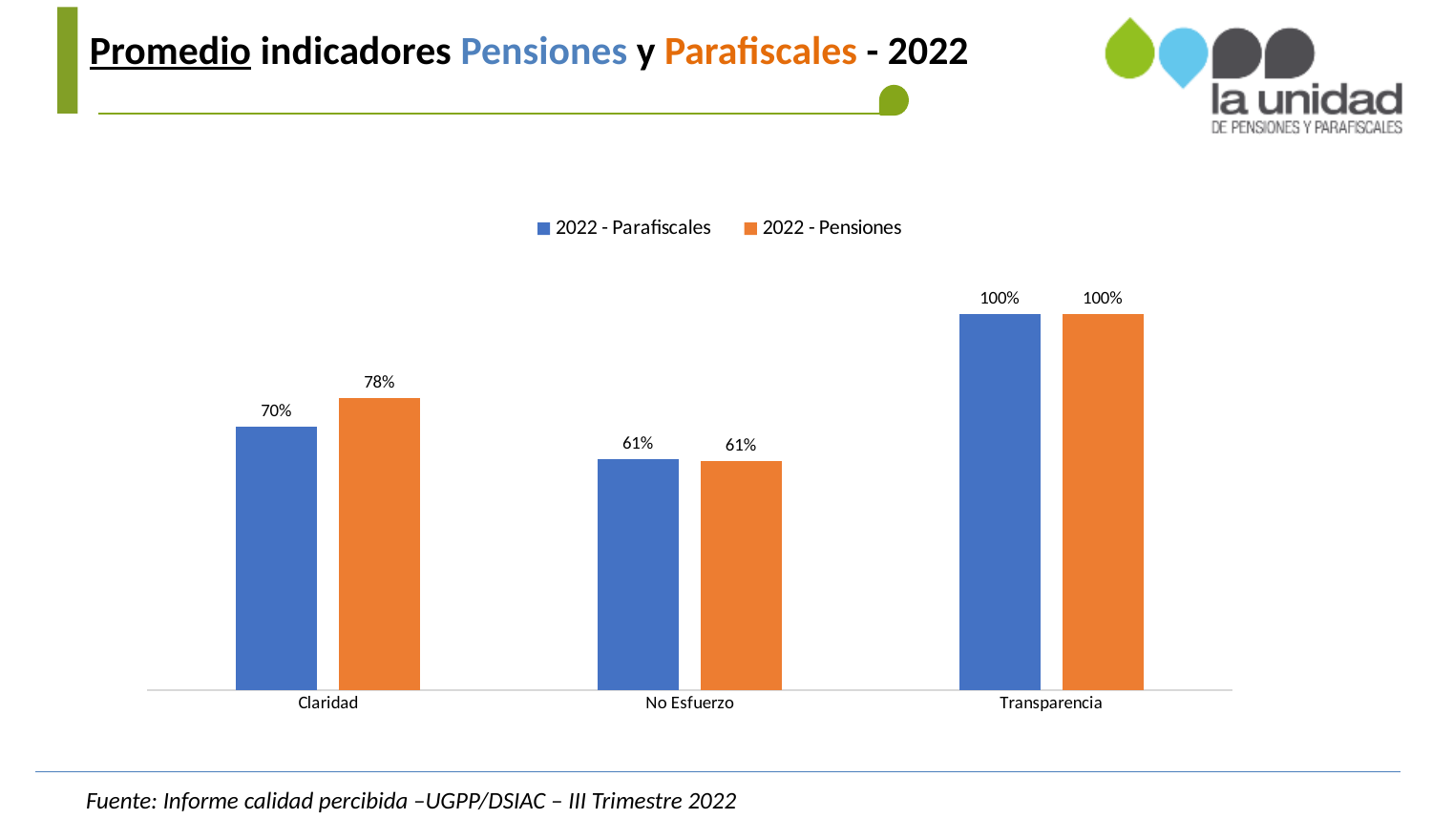
Which category has the lowest value for 2022 - Parafiscales? No Esfuerzo What kind of chart is shown on the slide? Bar chart What is the value for 2022 - Parafiscales in the Claridad category? 70% What is the value for 2022 - Parafiscales in the Transparencia category? 100% What colour represents the 2022 - Pensiones series? Orange What is the difference between the 2022 - Pensiones and 2022 - Parafiscales values in the Claridad category? 8% What is the value for 2022 - Pensiones in the No Esfuerzo category? 61% In the Claridad category, which series has the larger value, 2022 - Parafiscales or 2022 - Pensiones? 2022 - Pensiones How many series does the legend list? 2 How many categories are shown on the x axis? 3 What is the value for 2022 - Pensiones in the Claridad category? 78% Which category has the highest value for 2022 - Pensiones? Transparencia